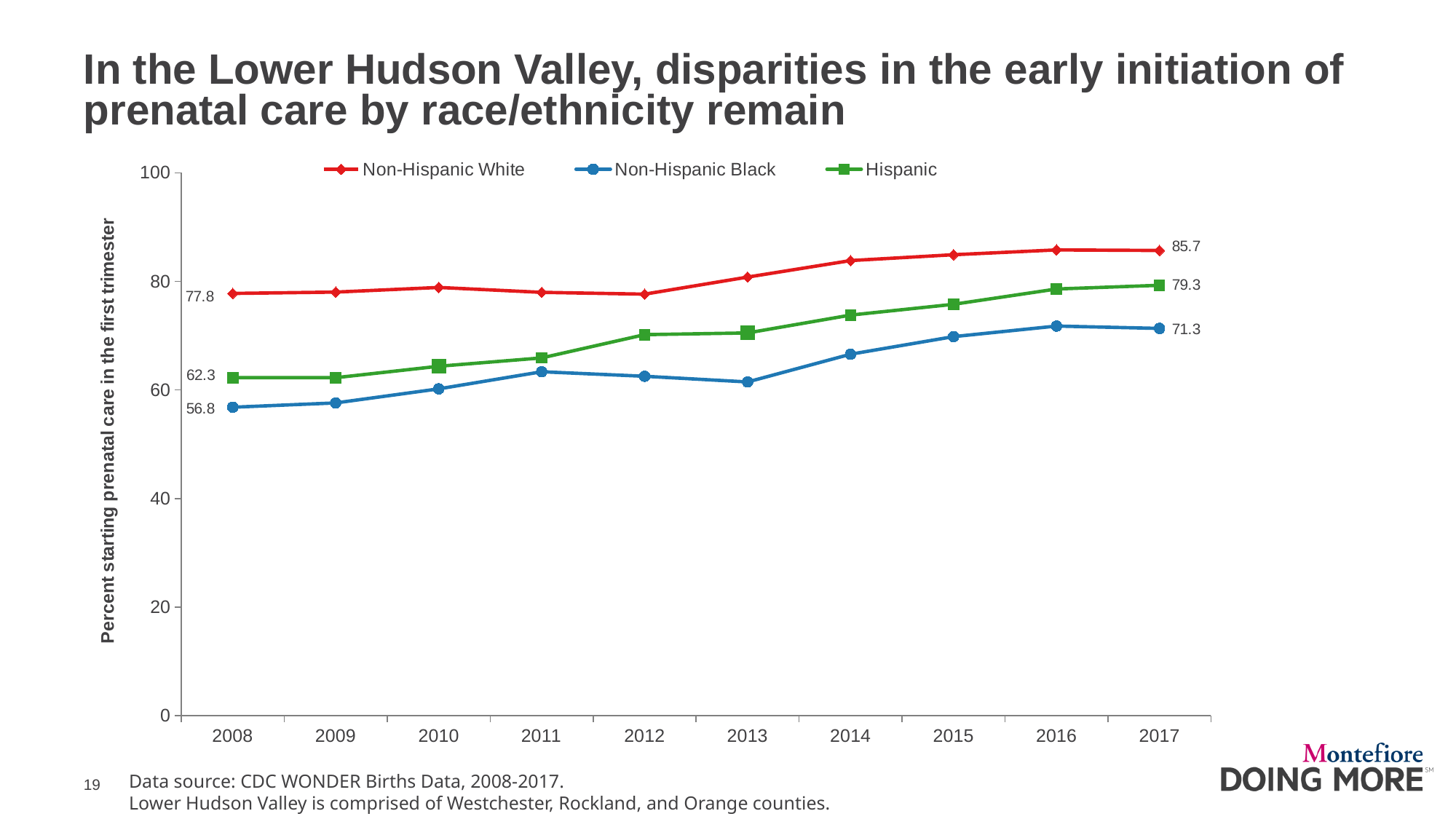
How many years are shown on the x axis? 10 What is the value for Non-Hispanic Black in 2017? 71.3 What is the value for Non-Hispanic White in 2008? 77.8 Which series has the lowest value in 2008? Non-Hispanic Black What kind of chart is shown on the slide? line chart Does the Hispanic series rise or fall from 2008 to 2017? rise Which series has the highest value in 2017? Non-Hispanic White What is the difference between the Non-Hispanic White and Non-Hispanic Black values in 2017? 14.4 Is the value for Non-Hispanic Black in 2013 greater or less than 60? greater How many series does the legend list? 3 What is the value for Hispanic in 2017? 79.3 What is the value for Non-Hispanic Black in 2008? 56.8